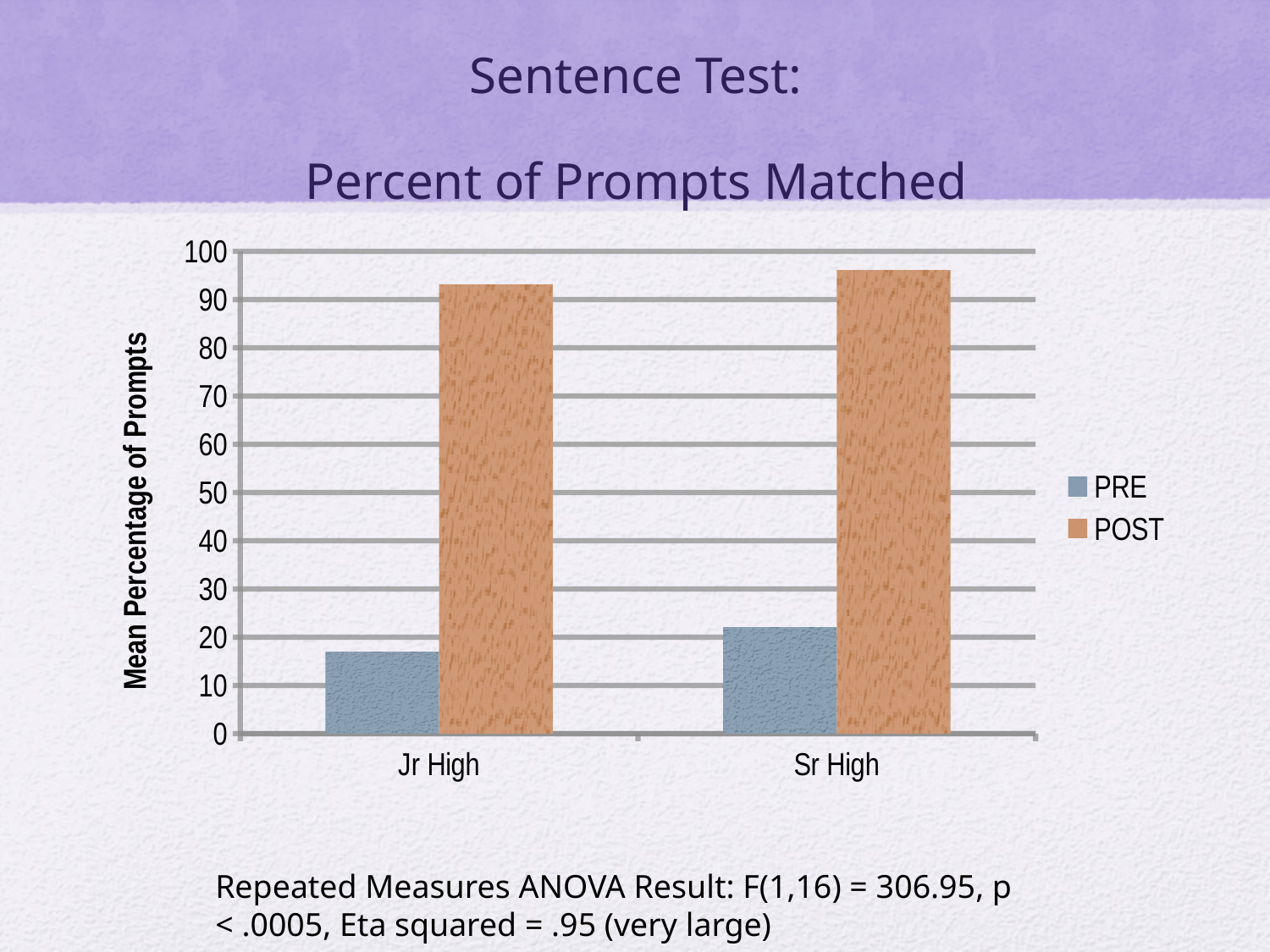
What is the label of the vertical axis? Mean Percentage of Prompts How many categories are shown on the x axis? 2 Is the PRE value for Sr High greater or less than 30? less Is the POST value for Sr High greater or less than 90? greater How many series does the legend list? 2 Which bar is the lowest in the chart? PRE for Jr High Is the PRE value for Jr High greater or less than 20? less Which category has the higher PRE value, Jr High or Sr High? Sr High Which series is shown in orange? POST Which is larger for Sr High, the PRE value or the POST value? POST What kind of chart is shown on the slide? bar chart